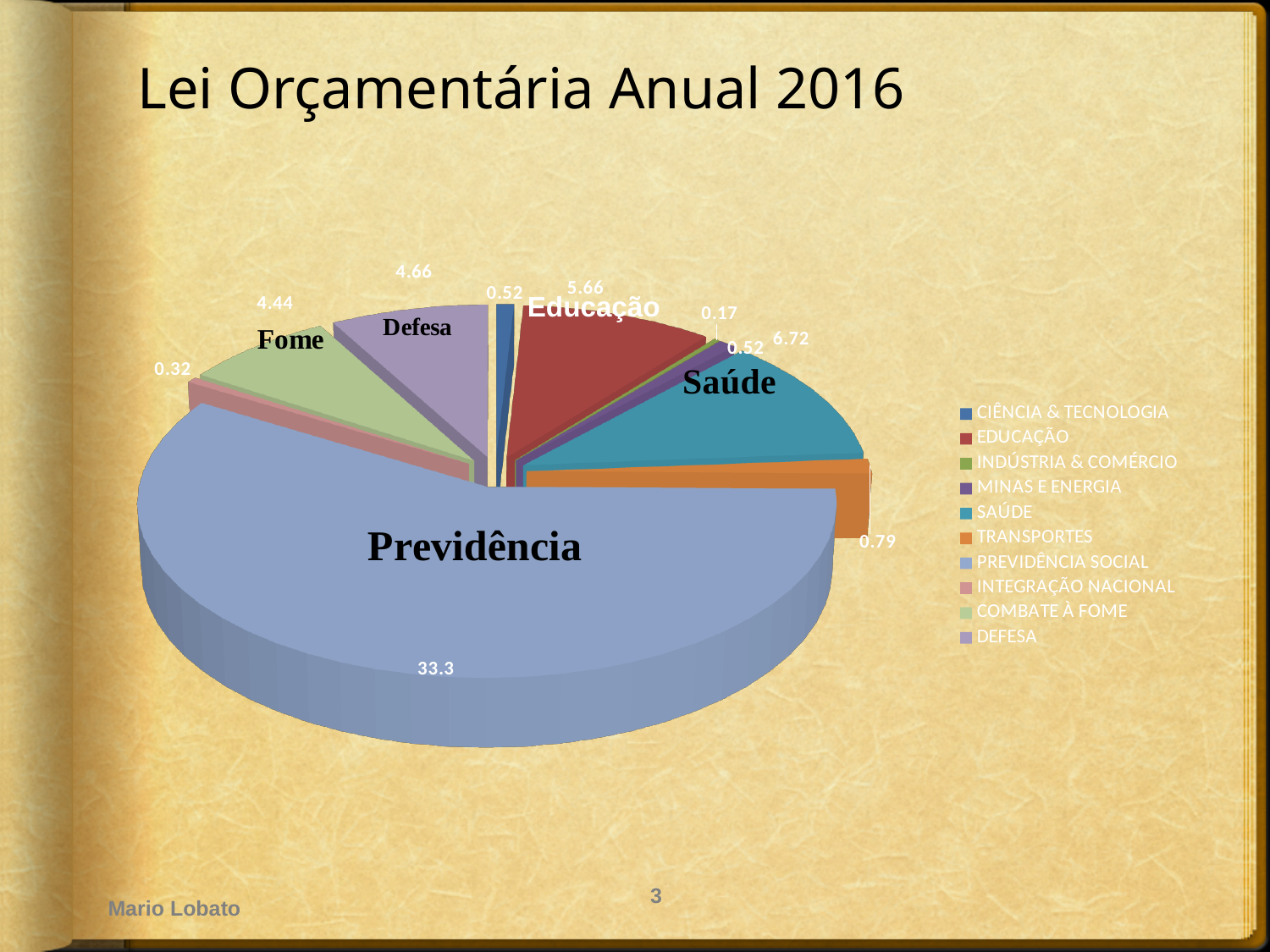
What is the difference between the values for Saúde and Educação? 1.06 What type of chart is shown on the slide? pie chart What is the value shown for Saúde? 6.72 Which category has the smallest value in the pie chart? Indústria & Comércio What is the value shown for Educação? 5.66 Which is larger, the value for Defesa or the value for Combate à Fome? Defesa Which category has the largest slice of the pie? Previdência Social How many categories does the legend list? 10 What is the value shown for Transportes? 0.79 What is the value shown for Combate à Fome? 4.44 What is the value shown for Previdência Social? 33.3 What is the value shown for Defesa? 4.66